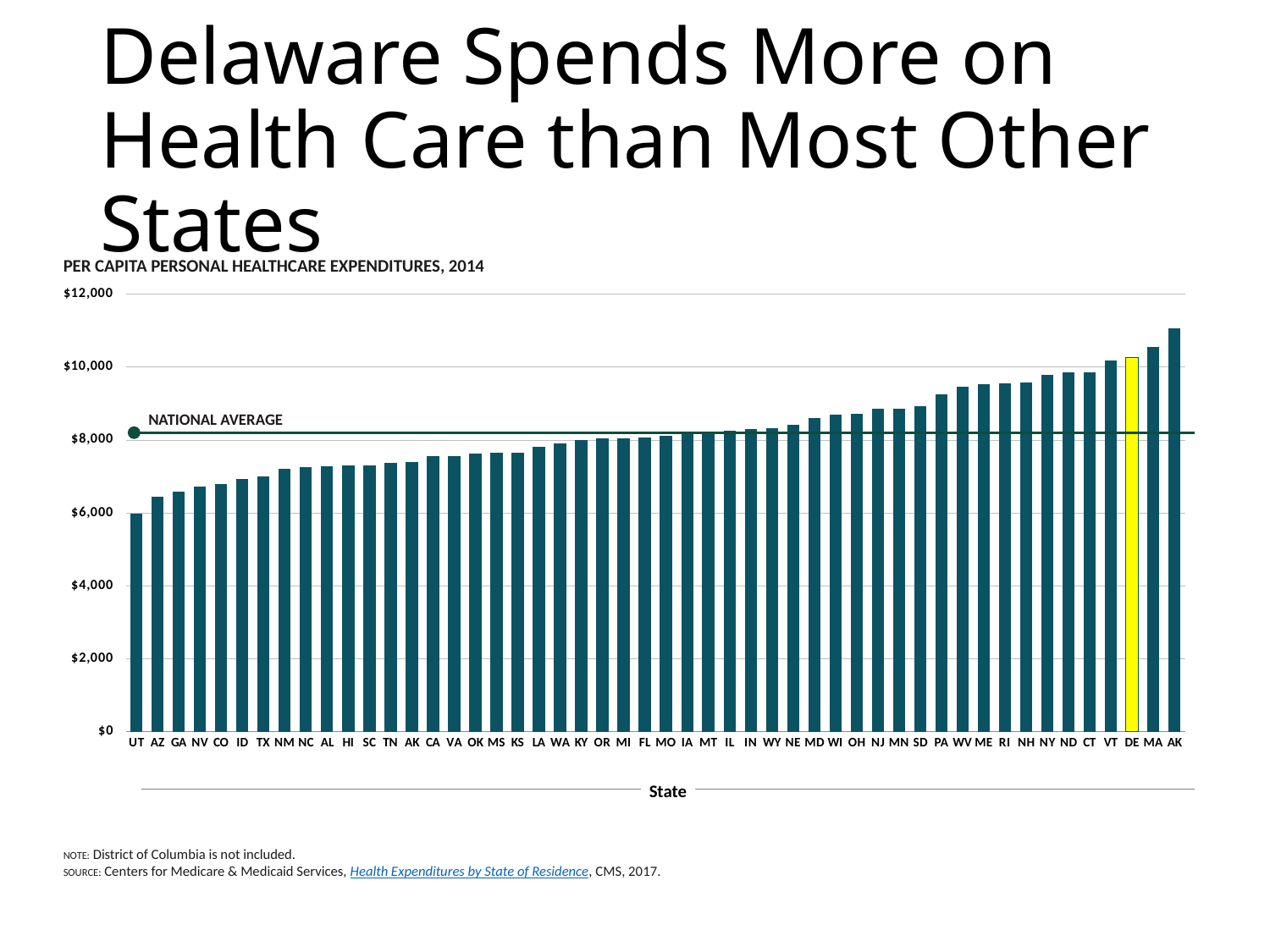
Is the value for UT greater or less than $8,000? less Is the value for GA greater or less than $8,000? less Is the value for MA greater or less than $10,000? greater Do the bar values rise or fall moving from left to right along the x axis? rise What kind of chart is shown on the slide? bar chart How many states (bars) are shown in the chart? 50 Which state's bar is highlighted in yellow? DE Which has a higher per capita healthcare expenditure, DE or UT? DE Which state has the highest per capita personal healthcare expenditure in the chart? AK Which state has the lowest per capita personal healthcare expenditure in the chart? UT